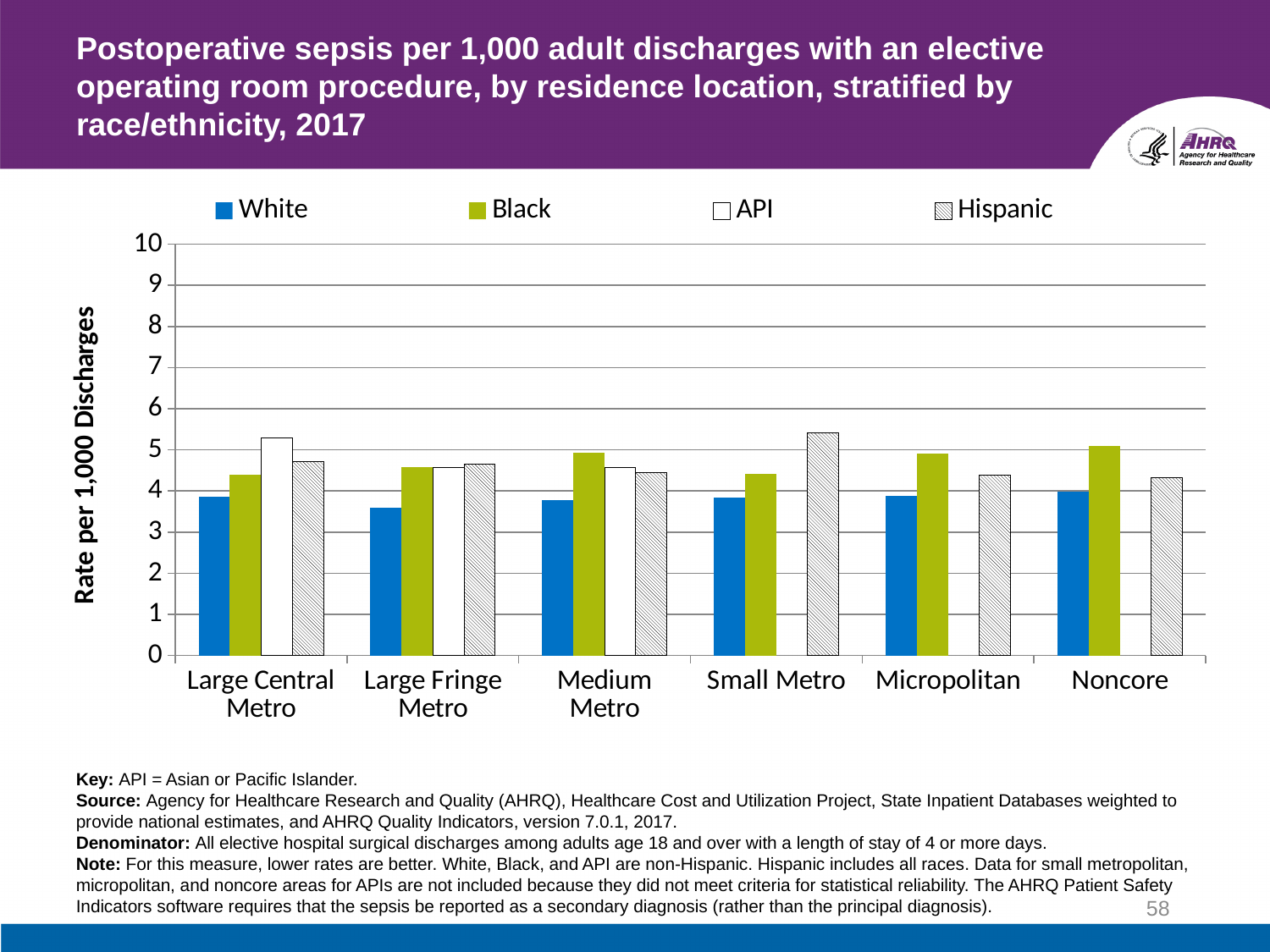
Is the value for White in Large Central Metro greater or less than 4? less Is the value for Black in Medium Metro greater or less than 4? greater In Small Metro, which is larger, the value for Hispanic or the value for Black? Hispanic Which series has the lowest value in Large Fringe Metro? White Is the value for API in Large Central Metro greater or less than 5? greater How many residence location categories are shown on the x axis? 6 Which series has no bars for Small Metro, Micropolitan, and Noncore? API How many series does the legend list? 4 What kind of chart is shown on the slide? bar chart Which series has the highest value in Large Central Metro? API In Large Central Metro, which is larger, the value for White or the value for Black? Black